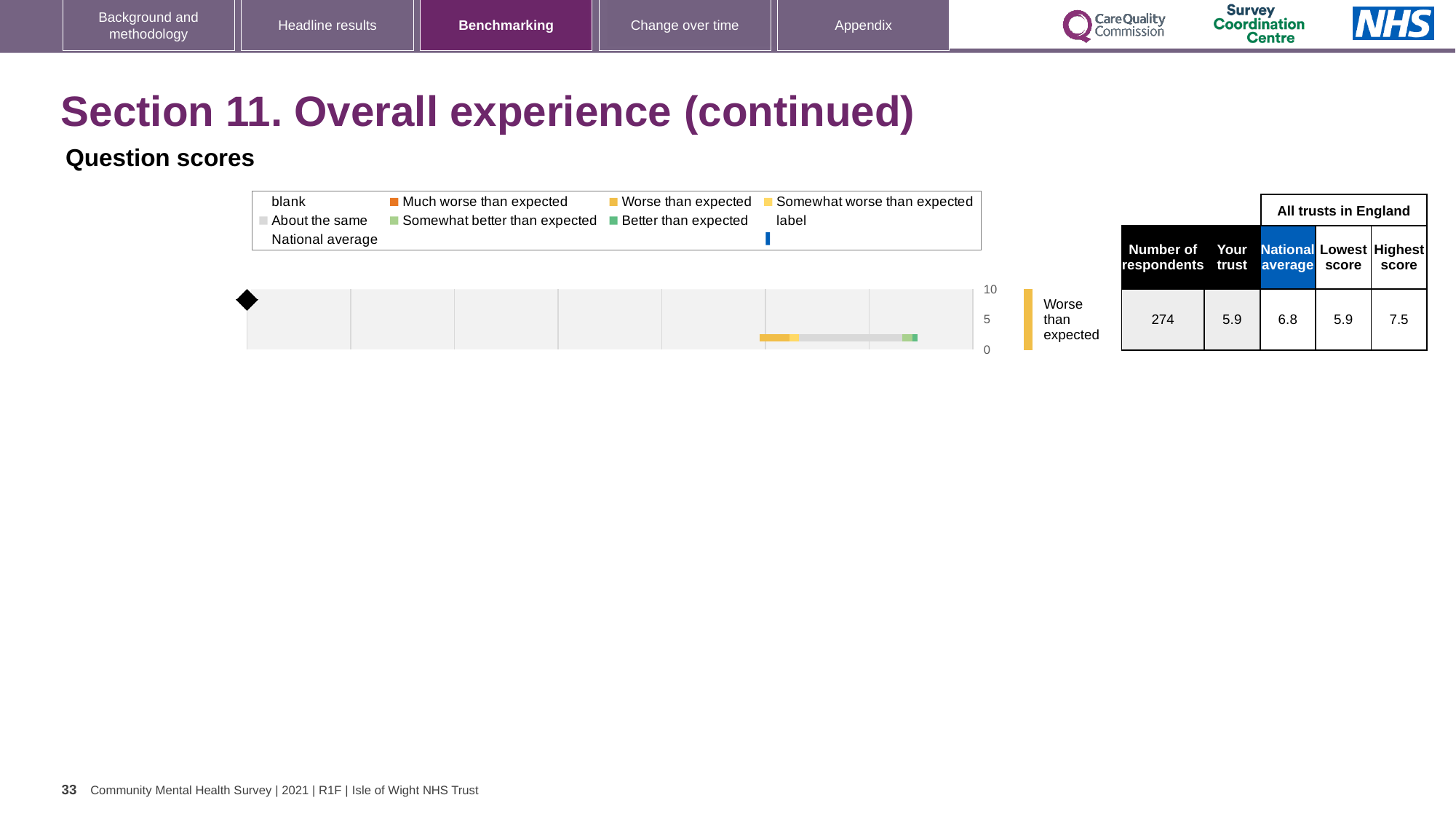
What is the highest value shown on the chart's axis? 10 What benchmark rating is shown next to the bar in the chart? Worse than expected What is the difference between the national average and the 'Your trust' score? 0.9 What is the 'Your trust' score shown in the table? 5.9 How many respondents are shown in the table? 274 What kind of chart is shown under 'Question scores'? bar chart What is the lowest score among all trusts in England? 5.9 Which is larger, the 'Your trust' score or the national average? National average How many question bars are plotted in the chart? 1 What is the difference between the highest score and the lowest score among all trusts in England? 1.6 What is the national average score shown in the table? 6.8 What is the highest score among all trusts in England? 7.5